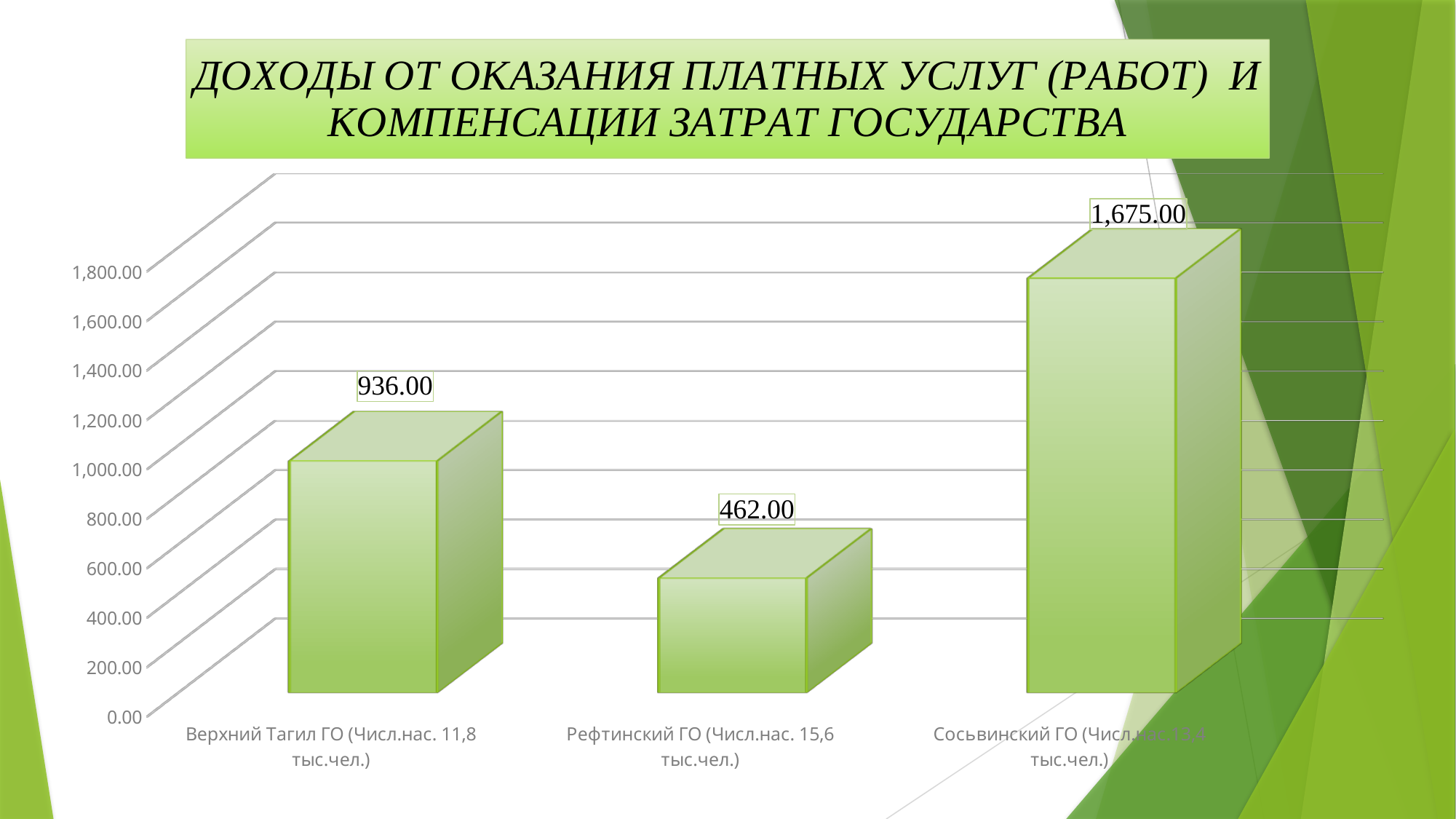
Is the value for Сосьвинский ГО greater or less than 1,600.00? greater Which is larger, the value for Верхний Тагил ГО or the value for Рефтинский ГО? Верхний Тагил ГО What is the value for Верхний Тагил ГО? 936.00 How many categories are shown in the chart? 3 What is the difference between the values for Верхний Тагил ГО and Рефтинский ГО? 474.00 Which category has the highest value? Сосьвинский ГО What is the title of the chart? ДОХОДЫ ОТ ОКАЗАНИЯ ПЛАТНЫХ УСЛУГ (РАБОТ) И КОМПЕНСАЦИИ ЗАТРАТ ГОСУДАРСТВА What is the value for Рефтинский ГО? 462.00 Which category has the lowest value? Рефтинский ГО What kind of chart is shown on the slide? bar chart What is the value for Сосьвинский ГО? 1,675.00 What is the difference between the values for Сосьвинский ГО and Верхний Тагил ГО? 739.00